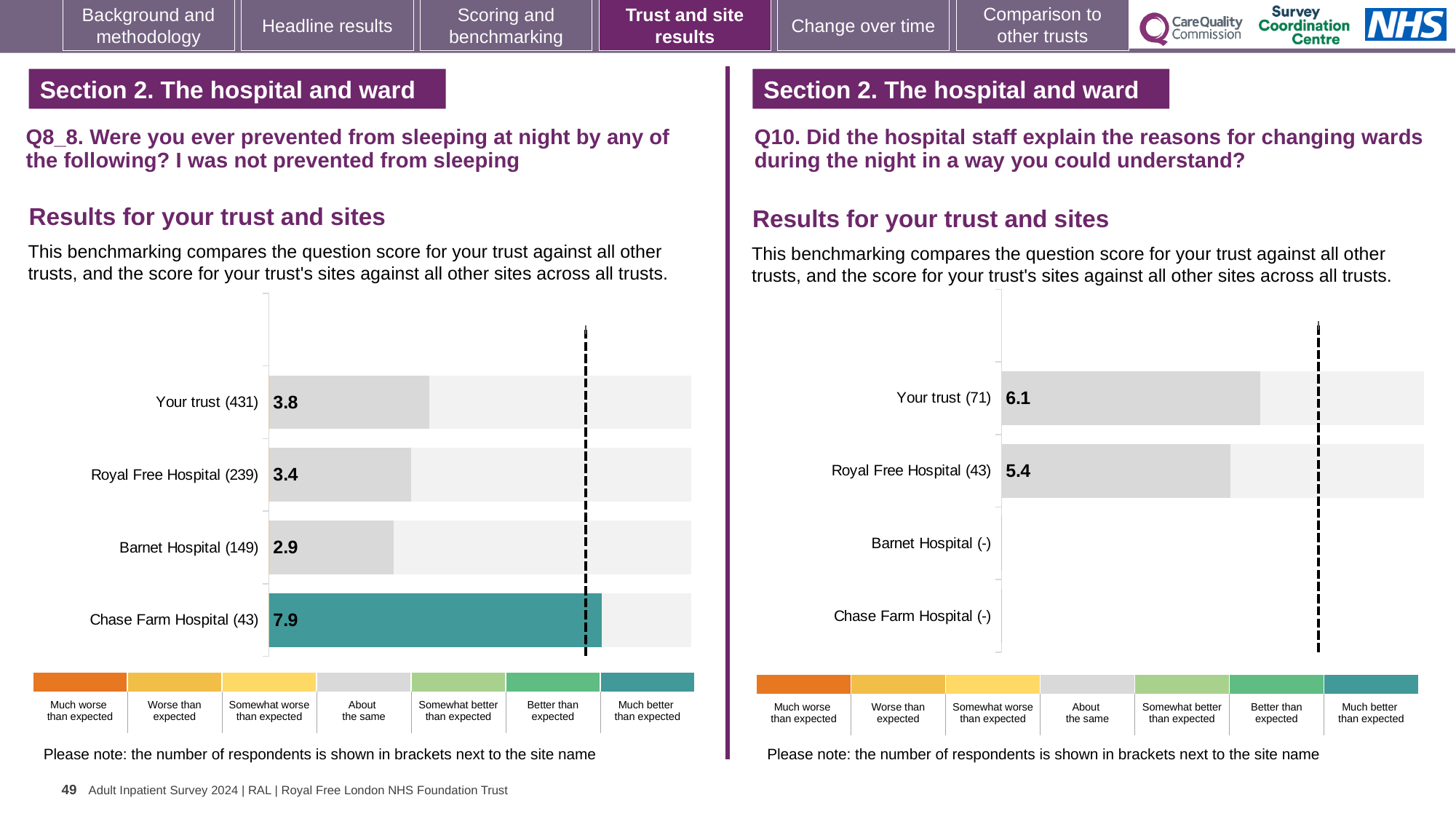
In the Q8_8 chart on the left, which site has the lowest score? Barnet Hospital In the Q8_8 chart on the left, what is the score for Your trust? 3.8 In the Q10 chart on the right, what is the score for Your trust? 6.1 In the Q10 chart on the right, what is the difference between the scores for Your trust and Royal Free Hospital? 0.7 In the Q10 chart on the right, how many respondents are shown for Your trust? 71 What kind of chart is used on the left side of the slide for Q8_8? Bar chart In the Q8_8 chart on the left, which has the higher score, Royal Free Hospital or Barnet Hospital? Royal Free Hospital In the Q8_8 chart on the left, which site has the highest score? Chase Farm Hospital In the Q8_8 chart on the left, which site's bar is coloured teal, indicating 'Much better than expected'? Chase Farm Hospital In the Q8_8 chart on the left, what is the score for Chase Farm Hospital? 7.9 In the Q10 chart on the right, what is the score for Royal Free Hospital? 5.4 In the Q8_8 chart on the left, what is the difference between the scores for Chase Farm Hospital and Barnet Hospital? 5.0